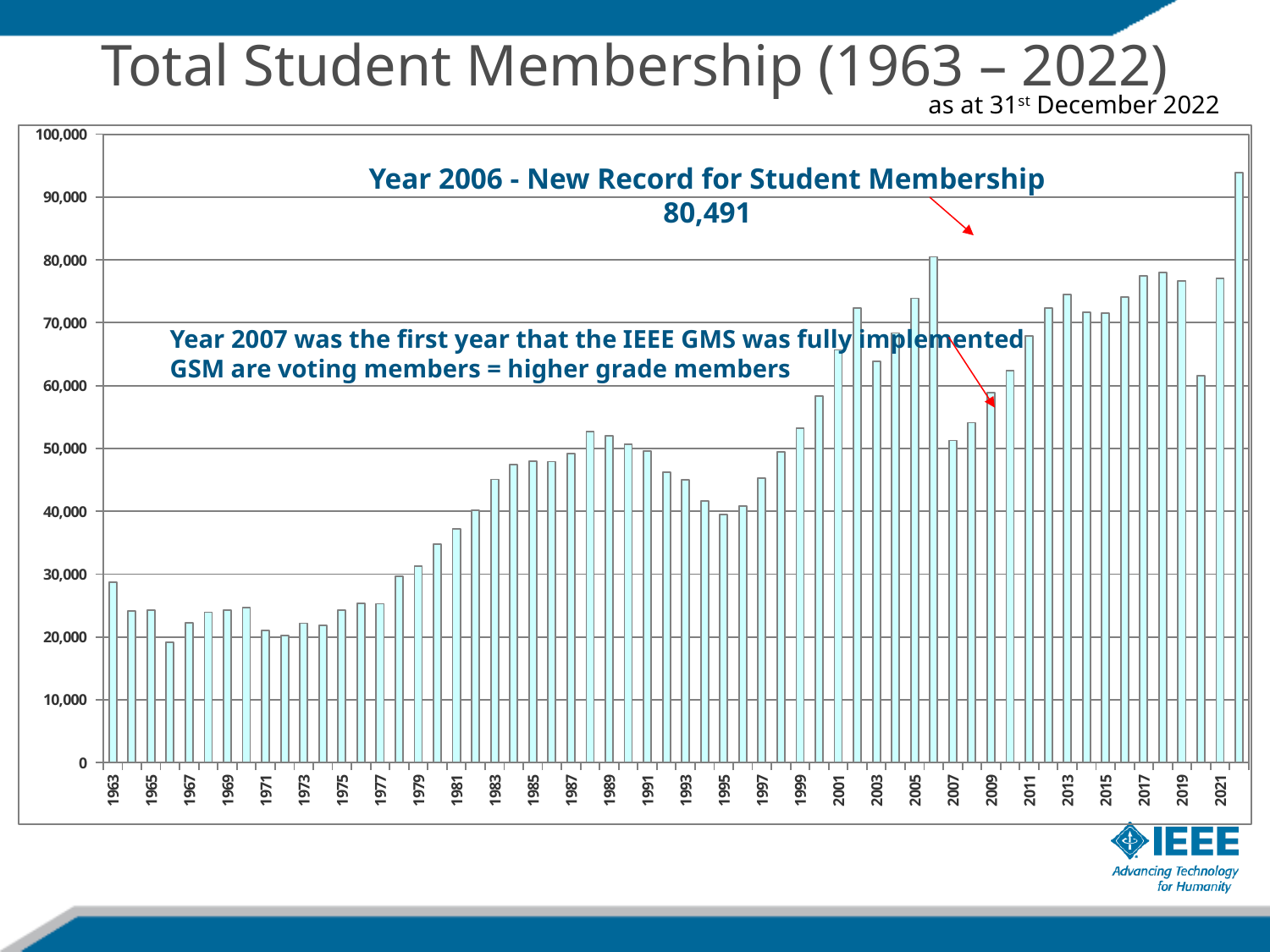
Is the value for 1963 greater or less than 20,000? greater What kind of chart is shown on the slide? bar chart Is the value for 2011 greater or less than 70,000? less Is the value for 1981 greater or less than 30,000? greater What is the highest value shown on the y axis of the chart? 100,000 Do the values generally rise or fall from 1977 to 1989? rise Which year has the larger value, 2013 or 2015? 2013 Do the values generally rise or fall from 1989 to 1995? fall Which year has the lowest bar on the chart? 1966 What was the total student membership in 2006, according to the annotation on the chart? 80,491 Which year has the larger value, 1963 or 1965? 1963